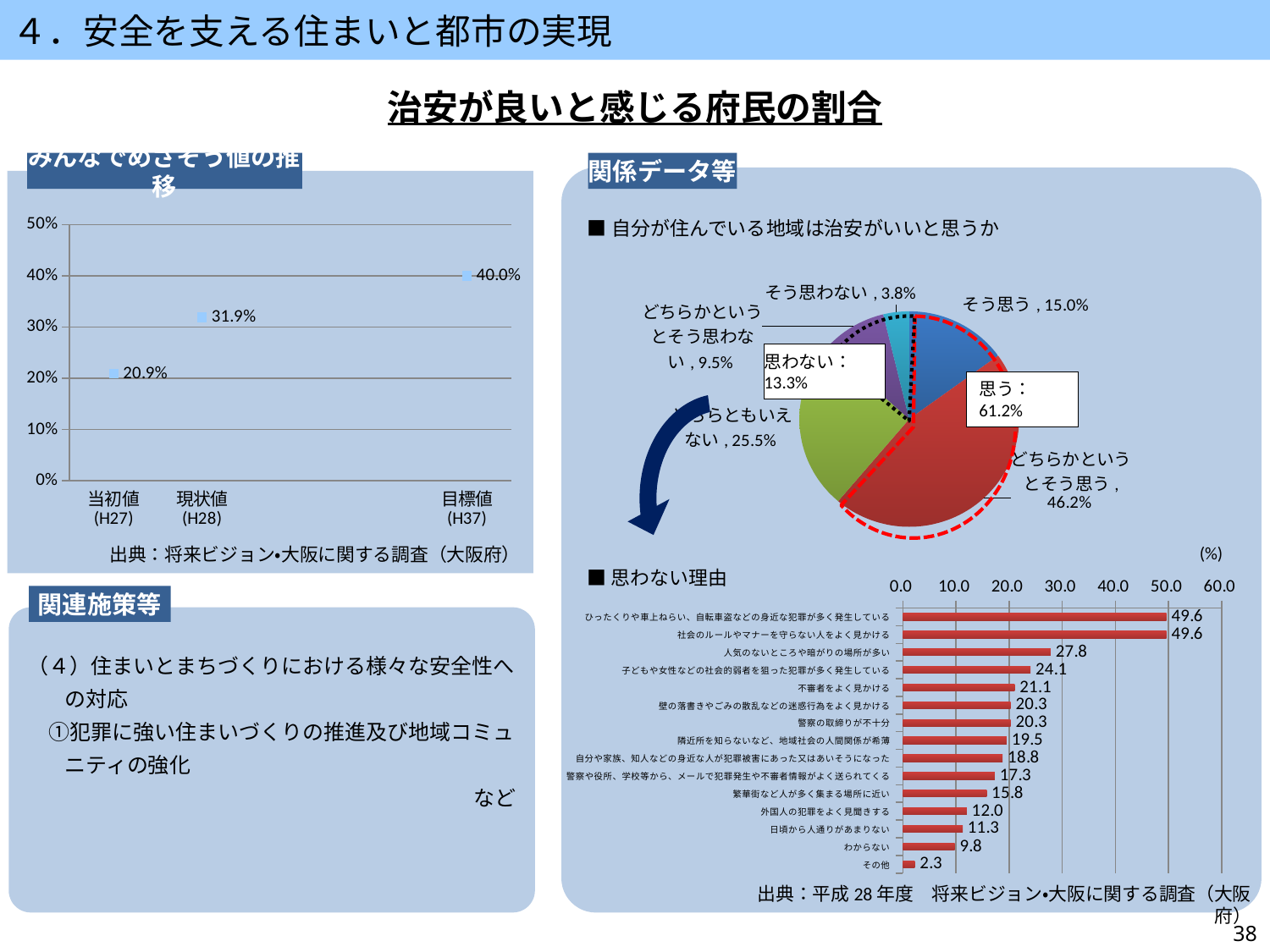
In the pie chart 自分が住んでいる地域は治安がいいと思うか, how many slices are there? 5 In the pie chart 自分が住んでいる地域は治安がいいと思うか, which slice is the smallest? そう思わない What kind of chart is used for 思わない理由? bar chart In the chart titled みんなでめざそう値の推移, do the values rise or fall from 当初値 (H27) to 目標値 (H37)? rise In the chart titled みんなでめざそう値の推移, how many data points are plotted? 3 What kind of chart is used for 自分が住んでいる地域は治安がいいと思うか? pie chart In the chart 思わない理由, which category has the lowest value? その他 In the chart 思わない理由, what is the difference between 人気のないところや暗がりの場所が多い and 子どもや女性などの社会的弱者を狙った犯罪が多く発生している? 3.7 In the chart titled みんなでめざそう値の推移, what is the value for 現状値 (H28)? 31.9% In the chart 思わない理由, what is the value for 人気のないところや暗がりの場所が多い? 27.8 In the chart titled みんなでめざそう値の推移, what is the value for 目標値 (H37)? 40.0% In the pie chart 自分が住んでいる地域は治安がいいと思うか, what share does どちらかというとそう思う have? 46.2%